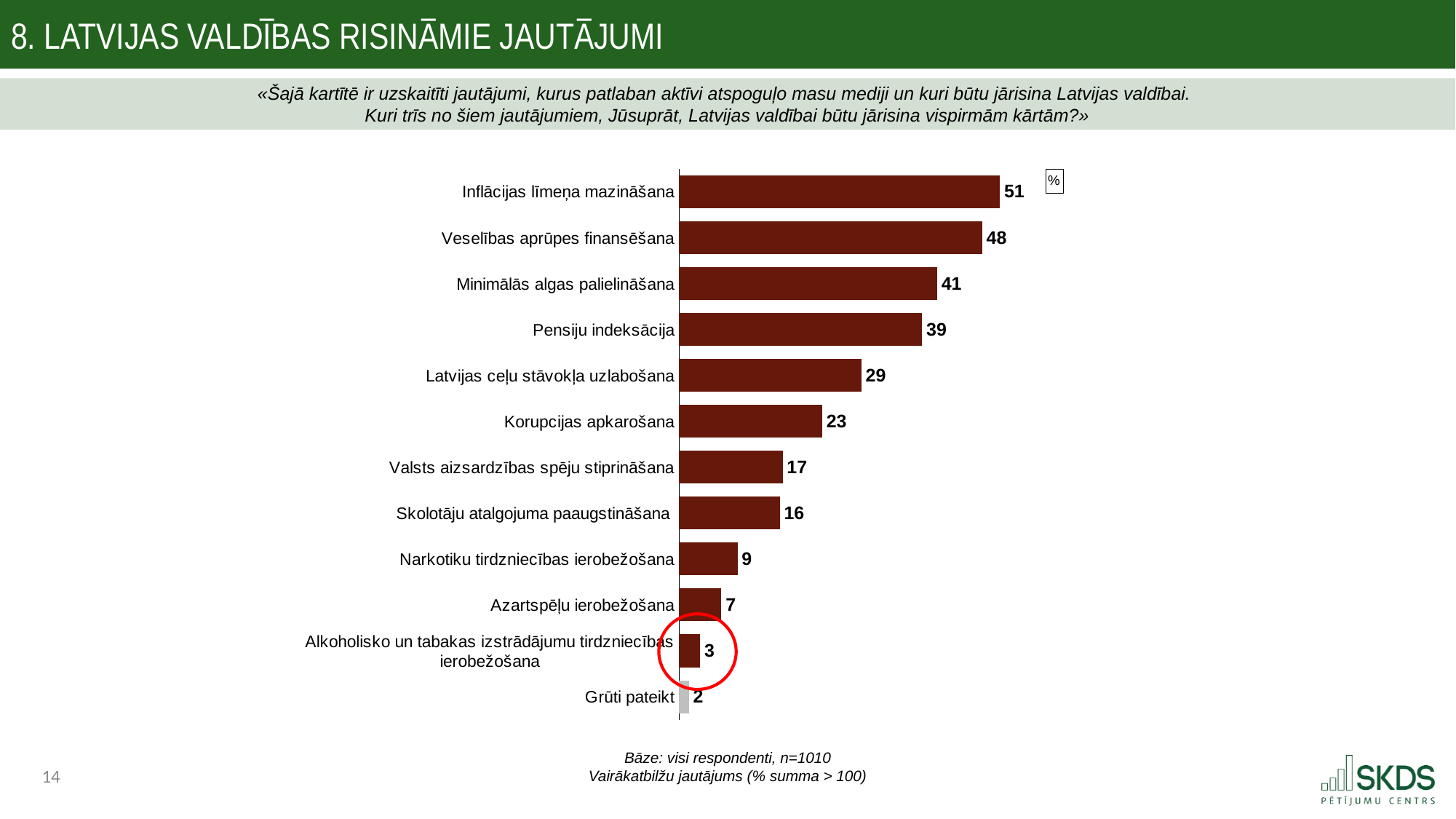
What is the difference between the values for Veselības aprūpes finansēšana and Minimālās algas palielināšana? 7 Which is larger: the value for Valsts aizsardzības spēju stiprināšana or Skolotāju atalgojuma paaugstināšana? Valsts aizsardzības spēju stiprināšana What is the value for Alkoholisko un tabakas izstrādājumu tirdzniecības ierobežošana? 3 What kind of chart is shown on the slide? Bar chart What is the value for Inflācijas līmeņa mazināšana? 51 What is the value for Pensiju indeksācija? 39 How many categories are shown in the chart? 12 What is the difference between the values for Latvijas ceļu stāvokļa uzlabošana and Korupcijas apkarošana? 6 What is the value for Narkotiku tirdzniecības ierobežošana? 9 Which category has the highest value? Inflācijas līmeņa mazināšana Which category has the lowest value? Grūti pateikt Which category's bar is circled in red on the chart? Alkoholisko un tabakas izstrādājumu tirdzniecības ierobežošana